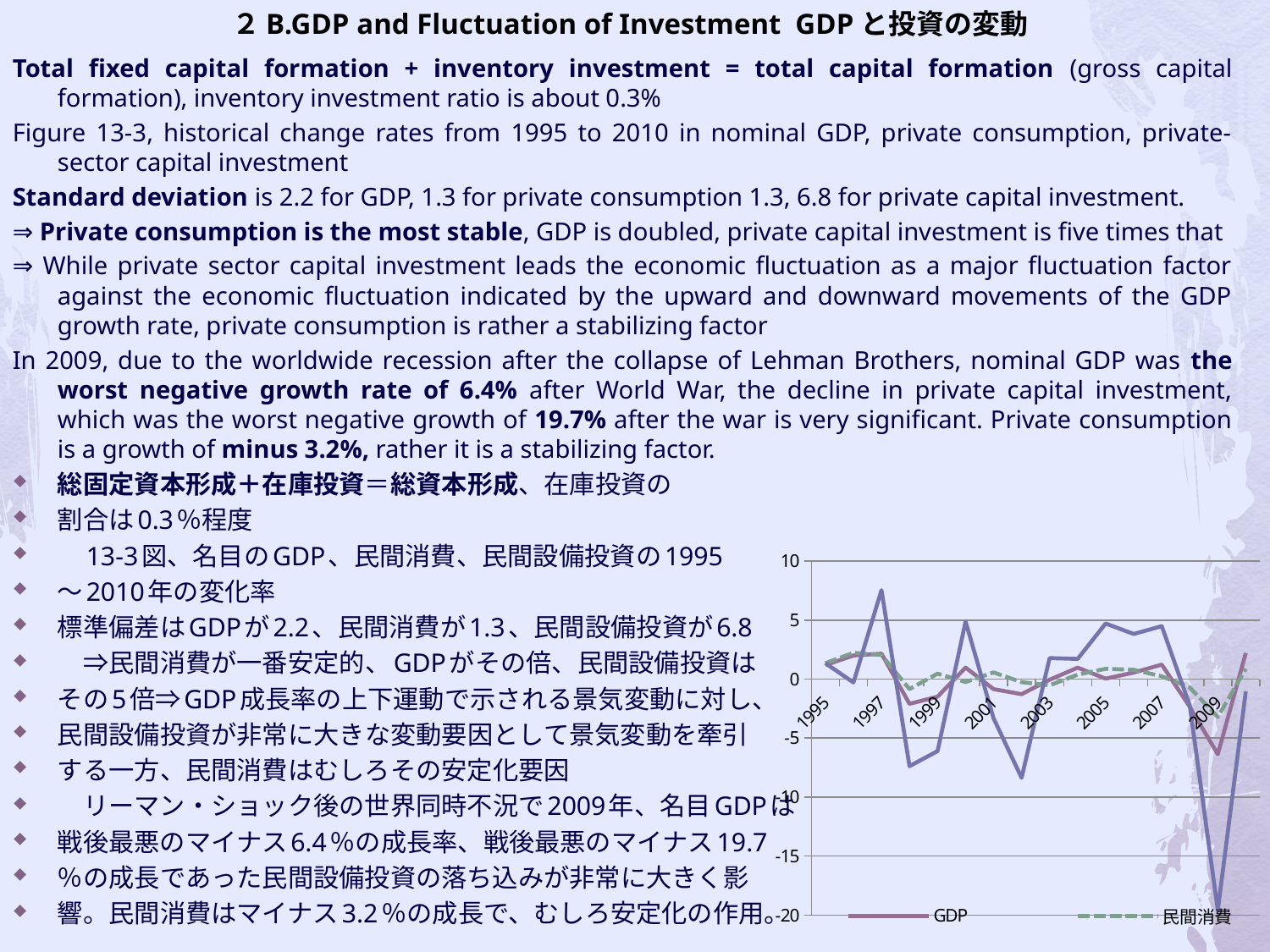
Does the GDP line rise or fall between 2007 and 2009? fall What kind of chart is shown on the slide? line chart Is the GDP value for 2009 greater or less than -5? less How many year labels are printed along the x axis of the chart? 8 Does the GDP line rise or fall between 2009 and the last year plotted? rise Which two series are named in the chart's legend? GDP and 民間消費 What are the lowest and highest values printed on the chart's y axis? -20 and 10 Is the 民間消費 value for 1997 greater or less than 5? less In which year does the GDP line reach its lowest point? 2009 Is the 民間消費 value for 2009 greater or less than -5? greater In 2009, which is larger, the GDP value or the 民間消費 value? 民間消費